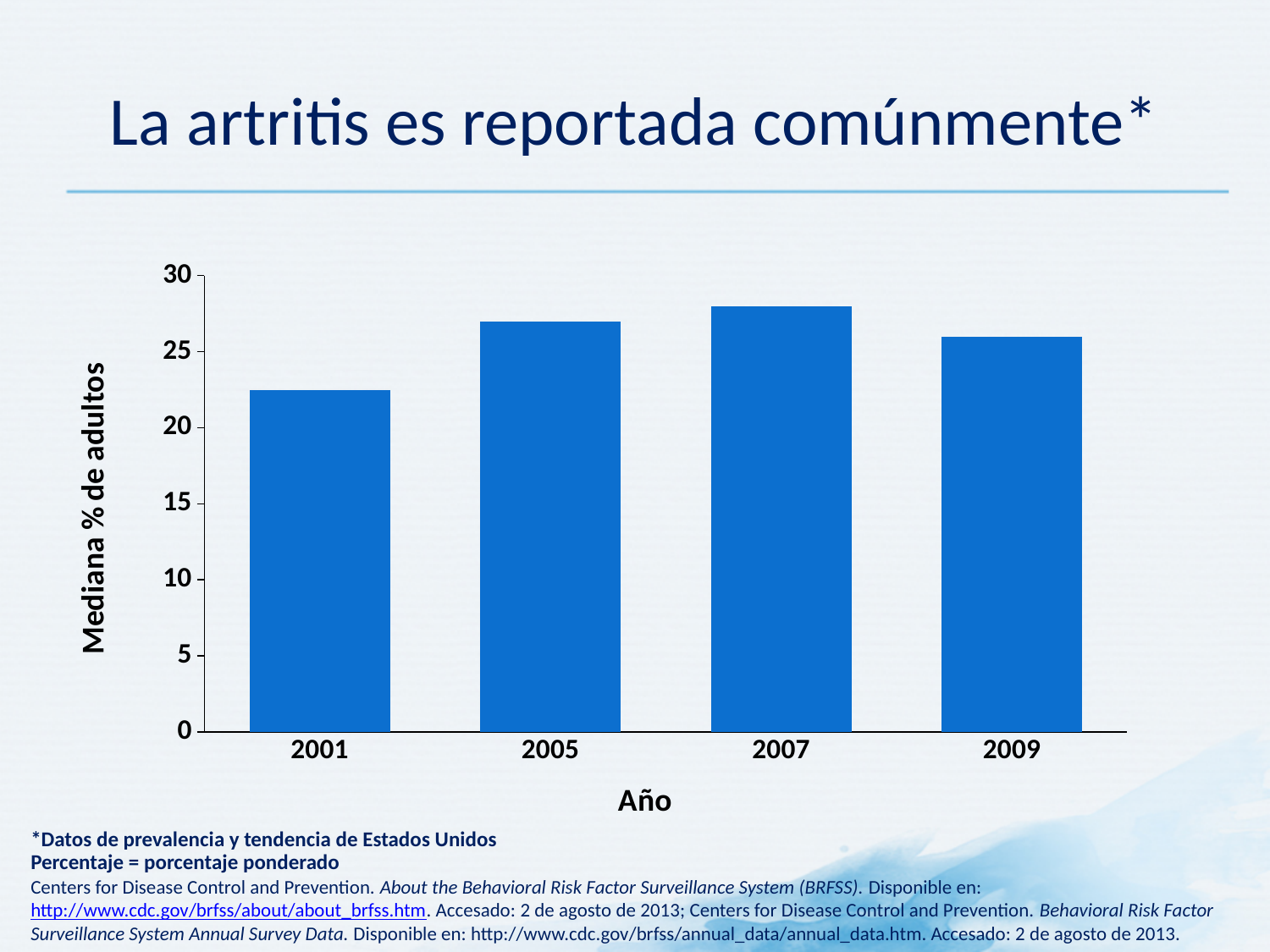
Which year has the highest median % of adults reporting arthritis? 2007 What kind of chart is shown on the slide? bar chart Is the value for 2001 greater or less than 25? less Is the value for 2005 greater or less than 25? greater Which year has the larger value, 2007 or 2009? 2007 Is the value for 2001 greater or less than 20? greater What is the label of the y axis of the chart? Mediana % de adultos How many years are shown on the x axis of the chart? 4 Which year has the larger value, 2001 or 2005? 2005 Does the value rise or fall from 2007 to 2009? fall Which year has the lowest median % of adults reporting arthritis? 2001